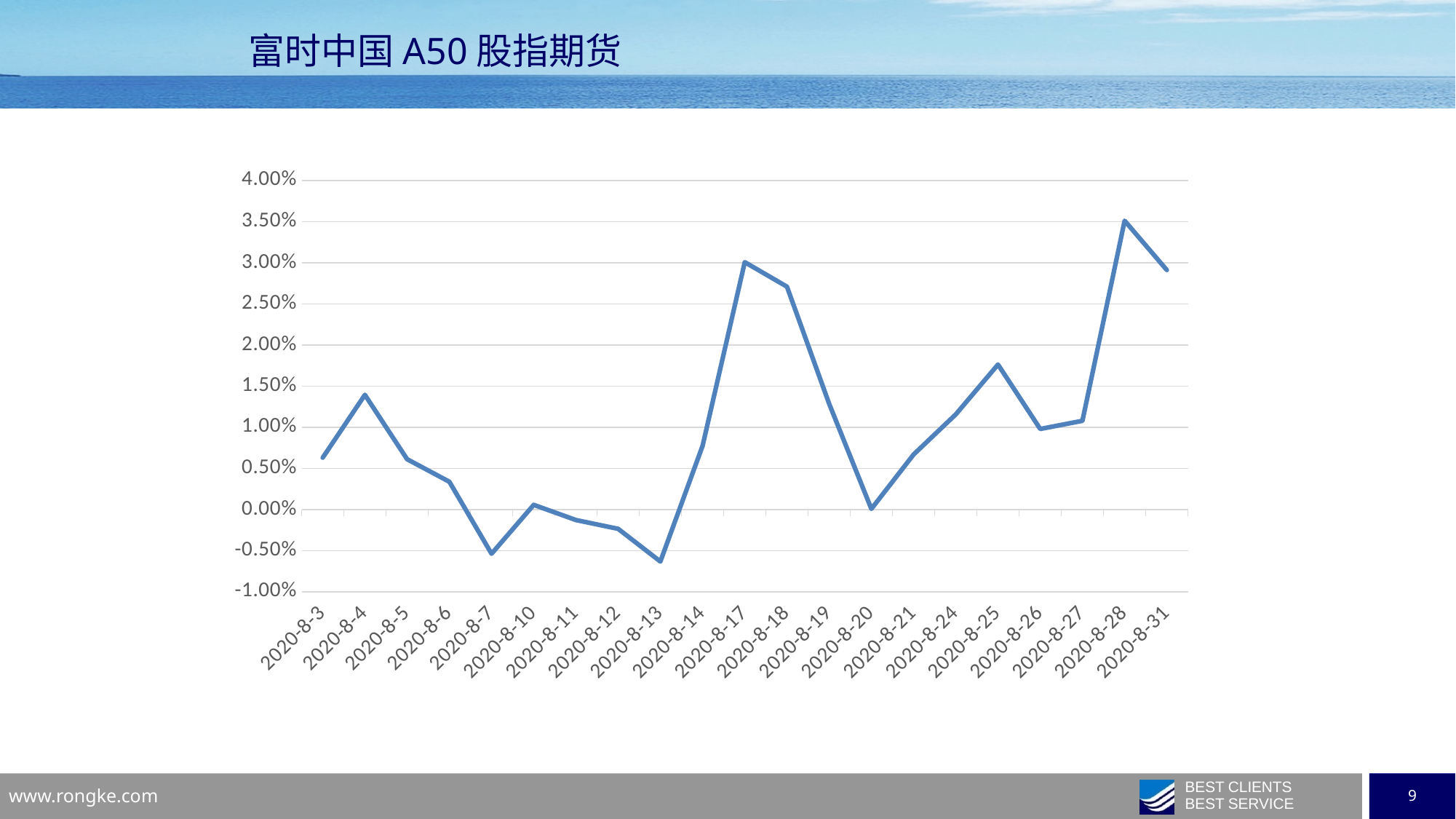
What kind of chart is shown on the slide? line chart What is the title of the chart? 富时中国 A50 股指期货 Is the value for 2020-8-17 greater or less than 2.00%? greater Is the value for 2020-8-25 greater or less than 1.50%? greater Which date has the higher value, 2020-8-28 or 2020-8-31? 2020-8-28 On which date does the line reach its highest value? 2020-8-28 Is the value for 2020-8-13 greater or less than 0.00%? less Does the line rise or fall from 2020-8-18 to 2020-8-20? fall How many dates are plotted along the x axis? 21 Which date has the higher value, 2020-8-17 or 2020-8-18? 2020-8-17 On which date does the line reach its lowest value? 2020-8-13